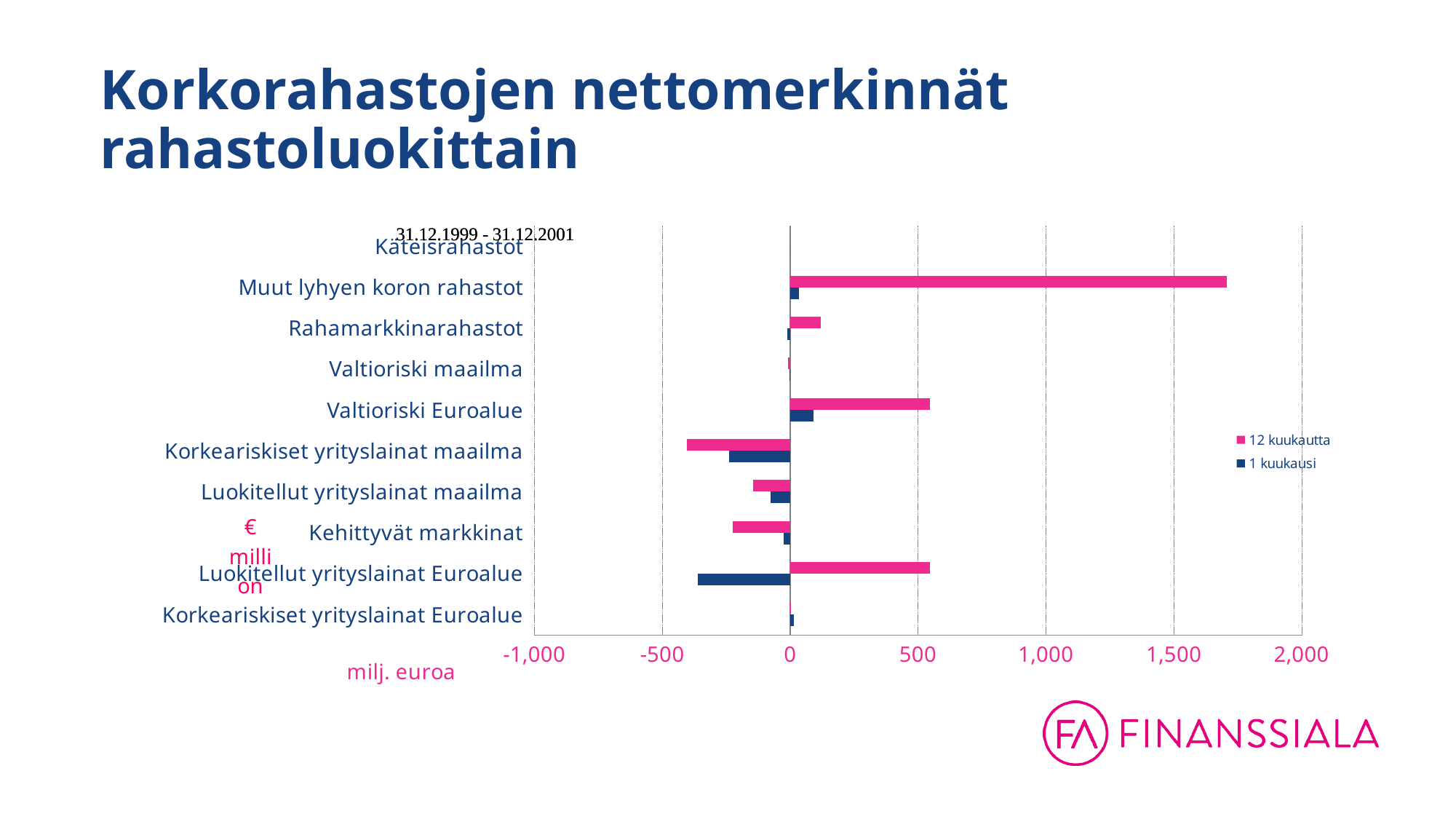
Is the 12 kuukautta value for Korkeariskiset yrityslainat maailma greater or less than -500? greater Is the 1 kuukausi value for Luokitellut yrityslainat Euroalue greater or less than 0? less Is the 12 kuukautta value for Muut lyhyen koron rahastot greater or less than 1,500? greater What unit is shown for the horizontal axis? milj. euroa Which category has the highest value for the 12 kuukautta series? Muut lyhyen koron rahastot Which category has the lowest value for the 12 kuukautta series? Korkeariskiset yrityslainat maailma How many fund categories are plotted on the chart? 10 How many series does the legend list? 2 Which category has the lowest value for the 1 kuukausi series? Luokitellut yrityslainat Euroalue What kind of chart is shown on the slide? bar chart For the 12 kuukautta series, which is larger: Muut lyhyen koron rahastot or Valtioriski Euroalue? Muut lyhyen koron rahastot